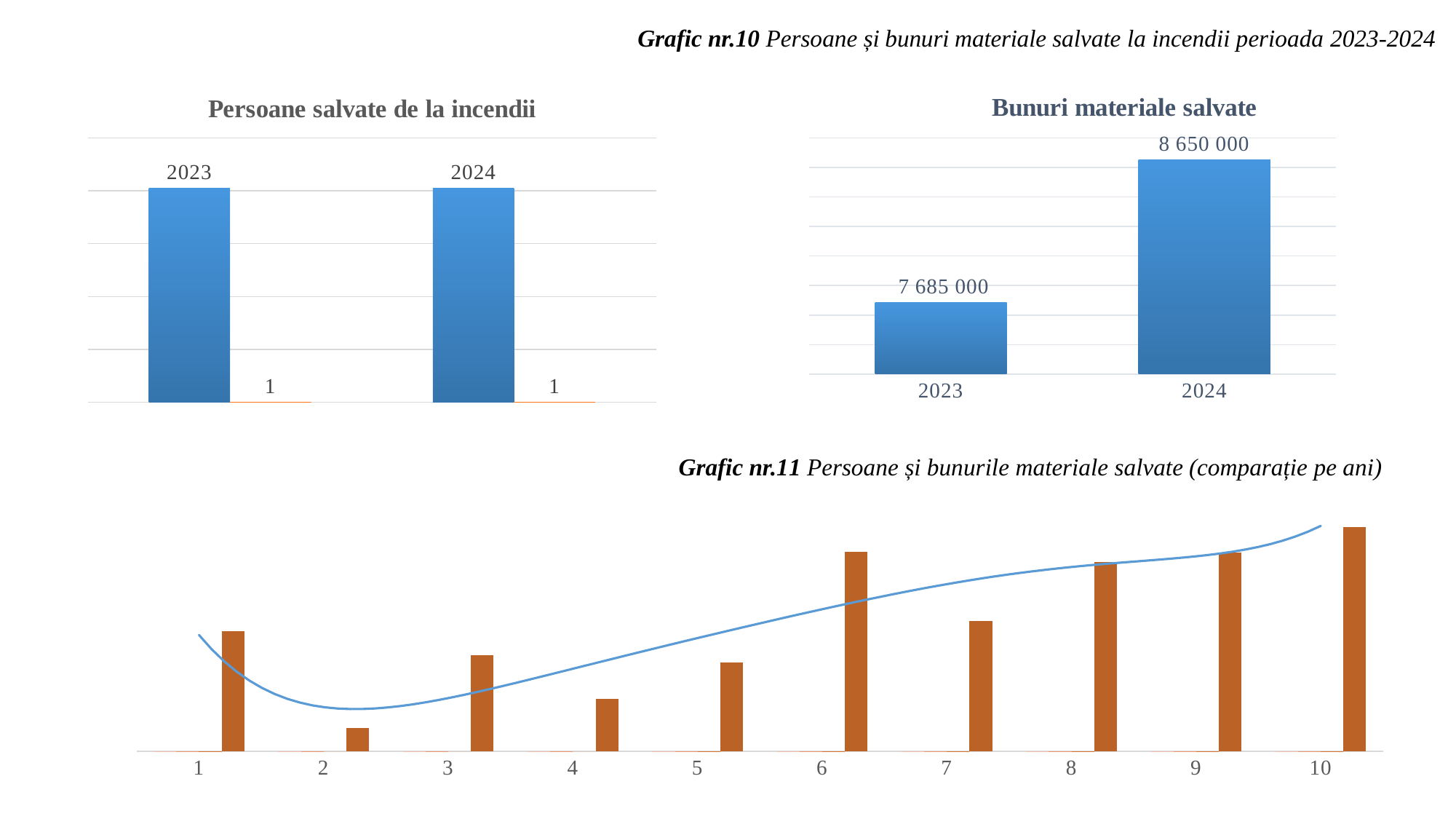
What kind of chart is 'Bunuri materiale salvate'? Bar chart In the Grafic nr.11 chart at the bottom, which category has the tallest bar? 10 In the 'Bunuri materiale salvate' chart, what is the difference between the 2024 and 2023 values? 965 000 In the Grafic nr.11 chart at the bottom, how many categories are on the x axis? 10 In the 'Bunuri materiale salvate' chart, what is the value for 2024? 8 650 000 In the 'Bunuri materiale salvate' chart, what is the value for 2023? 7 685 000 In the 'Persoane salvate de la incendii' chart, what value is printed on the orange bar for 2024? 1 In the 'Bunuri materiale salvate' chart, which year has the higher value? 2024 In the Grafic nr.11 chart at the bottom, which category has the shortest bar? 2 In the 'Persoane salvate de la incendii' chart, how many categories are shown on the x axis? 2 In the Grafic nr.11 chart at the bottom, is the bar for category 6 taller or shorter than the bar for category 4? Taller In the 'Bunuri materiale salvate' chart, how many years are shown? 2